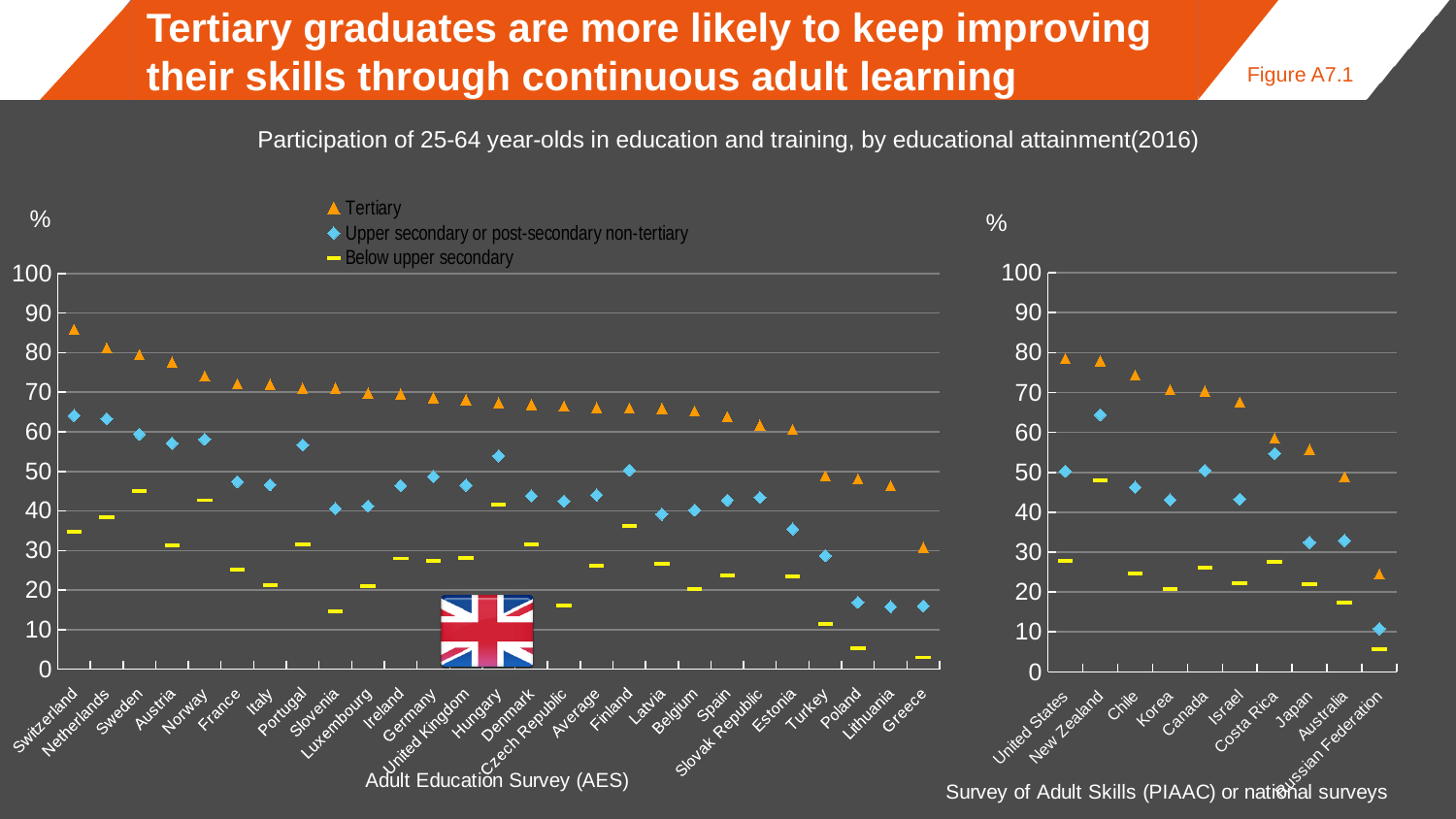
On the Adult Education Survey (AES) chart, which country has the lowest Tertiary value? Greece On the Survey of Adult Skills (PIAAC) chart, which country has the lowest Tertiary value? Russian Federation On the Adult Education Survey (AES) chart, which country has the highest Tertiary value? Switzerland On the Adult Education Survey (AES) chart, is the Tertiary value for Switzerland greater or less than 80? greater On the Adult Education Survey (AES) chart, which is larger: the Below upper secondary value for Sweden or for Slovenia? Sweden How many countries are shown on the Survey of Adult Skills (PIAAC) chart? 10 On the Survey of Adult Skills (PIAAC) chart, is the Below upper secondary value for the Russian Federation greater or less than 10? less On the Adult Education Survey (AES) chart, is the Below upper secondary value for Slovenia greater or less than 20? less How many series does the legend list? 3 On the Survey of Adult Skills (PIAAC) chart, which is larger: the Upper secondary or post-secondary non-tertiary value for the United States or for the Russian Federation? United States On the Adult Education Survey (AES) chart, do the Tertiary values generally rise or fall from left to right? fall